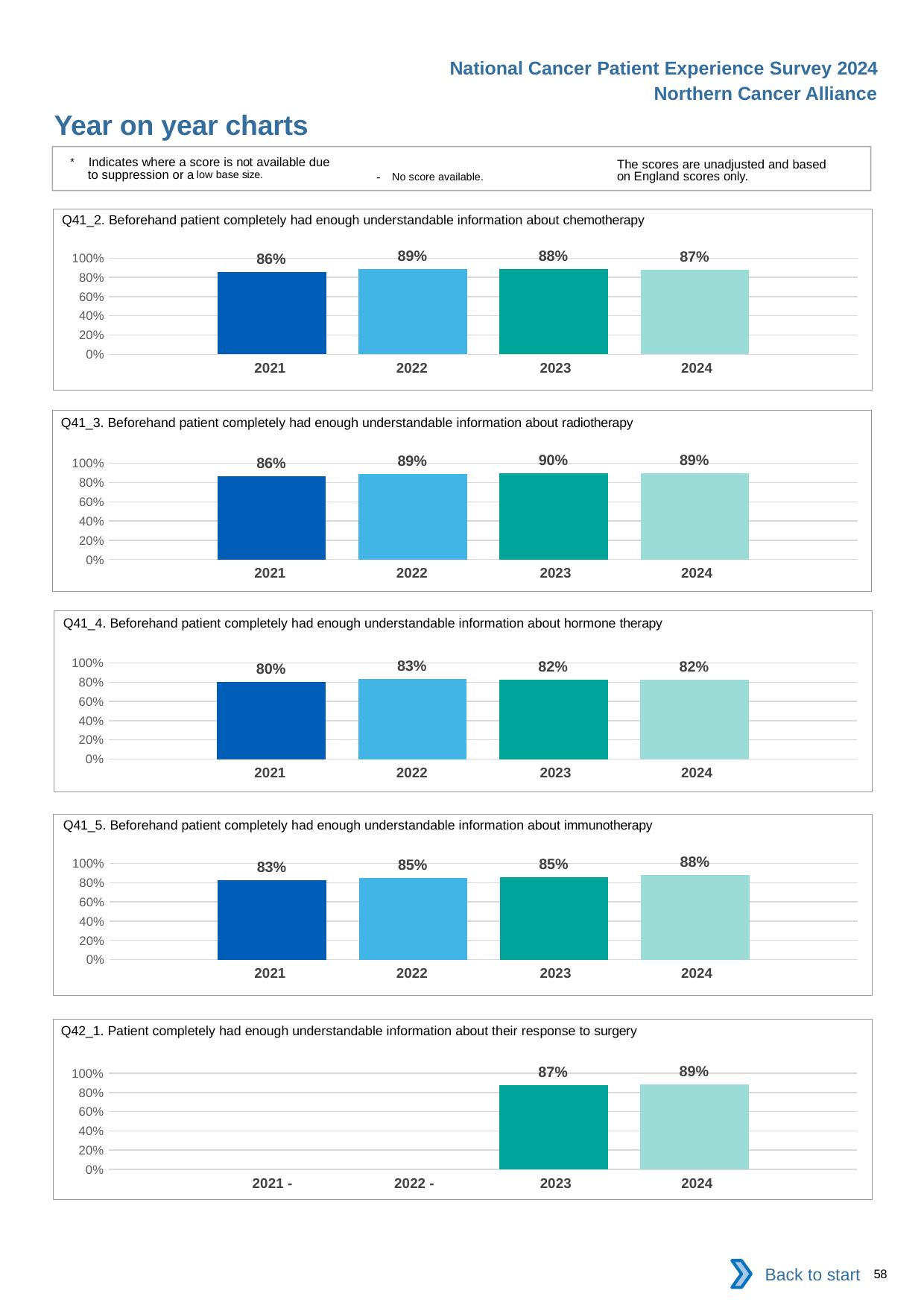
In the Q41_4 chart (hormone therapy), is the value for 2021 greater or less than 60%? greater In the Q41_5 chart (immunotherapy), what is the value for 2023? 85% In the Q41_3 chart (radiotherapy), which year has the highest value? 2023 How many charts are shown on the slide? 5 In the Q41_3 chart (radiotherapy), what is the value for 2024? 89% In the Q41_2 chart (chemotherapy), what is the value for 2022? 89% In the Q41_2 chart (chemotherapy), what is the difference between the 2022 value and the 2021 value? 3% In the Q41_5 chart (immunotherapy), what is the difference between the 2024 value and the 2021 value? 5% In the Q42_1 chart (response to surgery), which is larger, the value for 2023 or the value for 2024? 2024 What kind of chart is the Q41_2 chart (chemotherapy)? bar chart How many bars are plotted in the Q42_1 chart (response to surgery)? 2 In the Q41_4 chart (hormone therapy), which year has the lowest value? 2021